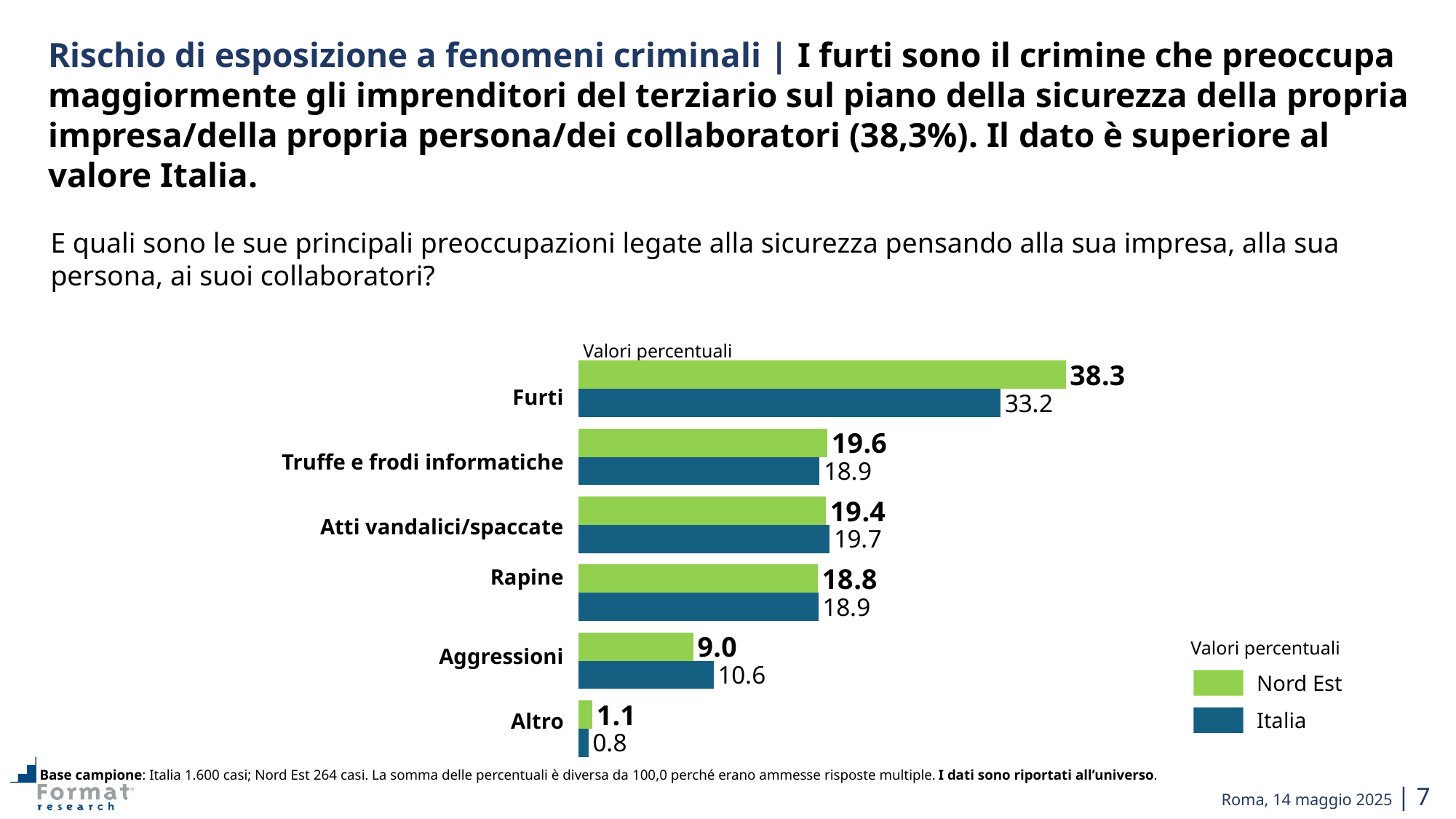
What is the Nord Est value for Furti? 38.3 What is the Italia value for Atti vandalici/spaccate? 19.7 Which colour represents the Nord Est series in the chart? Green Which category has the lowest Italia value? Altro What is the difference between the Italia and Nord Est values for Aggressioni? 1.6 For Aggressioni, which series has the larger value, Nord Est or Italia? Italia How many series does the legend list? 2 How many categories are shown in the chart? 6 Which category has the highest Nord Est value? Furti What is the difference between the Nord Est and Italia values for Furti? 5.1 What is the Italia value for Aggressioni? 10.6 What kind of chart is shown on the slide? Bar chart